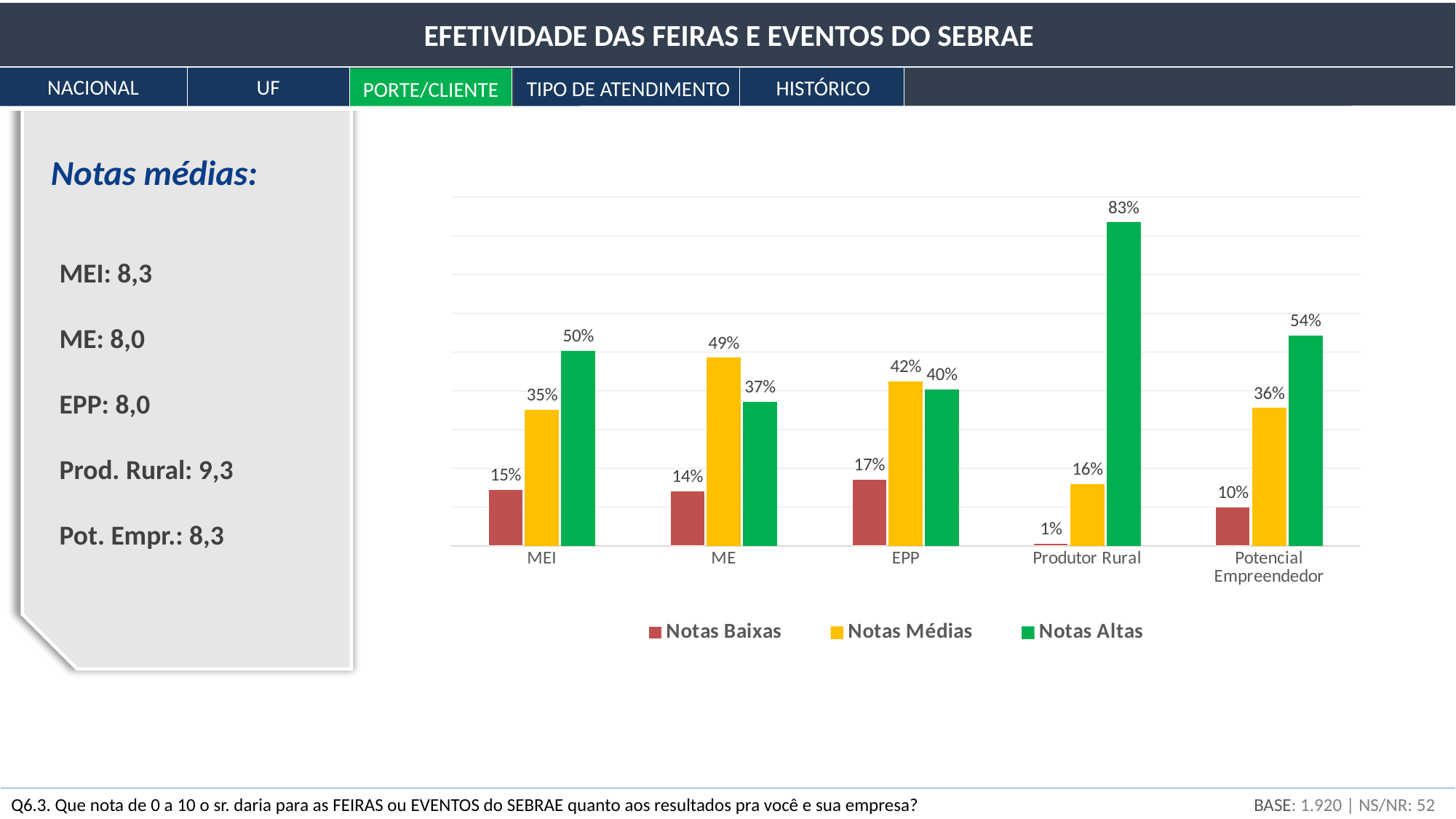
What kind of chart is shown on the slide? Bar chart Which category has the highest Notas Altas value? Produtor Rural Which category has the lowest Notas Baixas value? Produtor Rural What is the value of Notas Médias for ME? 49% Which colour represents Notas Baixas in the legend? Red How many categories are shown on the x axis? 5 What is the value of Notas Altas for Produtor Rural? 83% What is the difference between Notas Altas for Produtor Rural and Notas Altas for Potencial Empreendedor? 29% What is the difference between Notas Altas and Notas Médias for MEI? 15% For EPP, which is larger: Notas Médias or Notas Altas? Notas Médias How many series does the legend list? 3 What is the value of Notas Baixas for Potencial Empreendedor? 10%